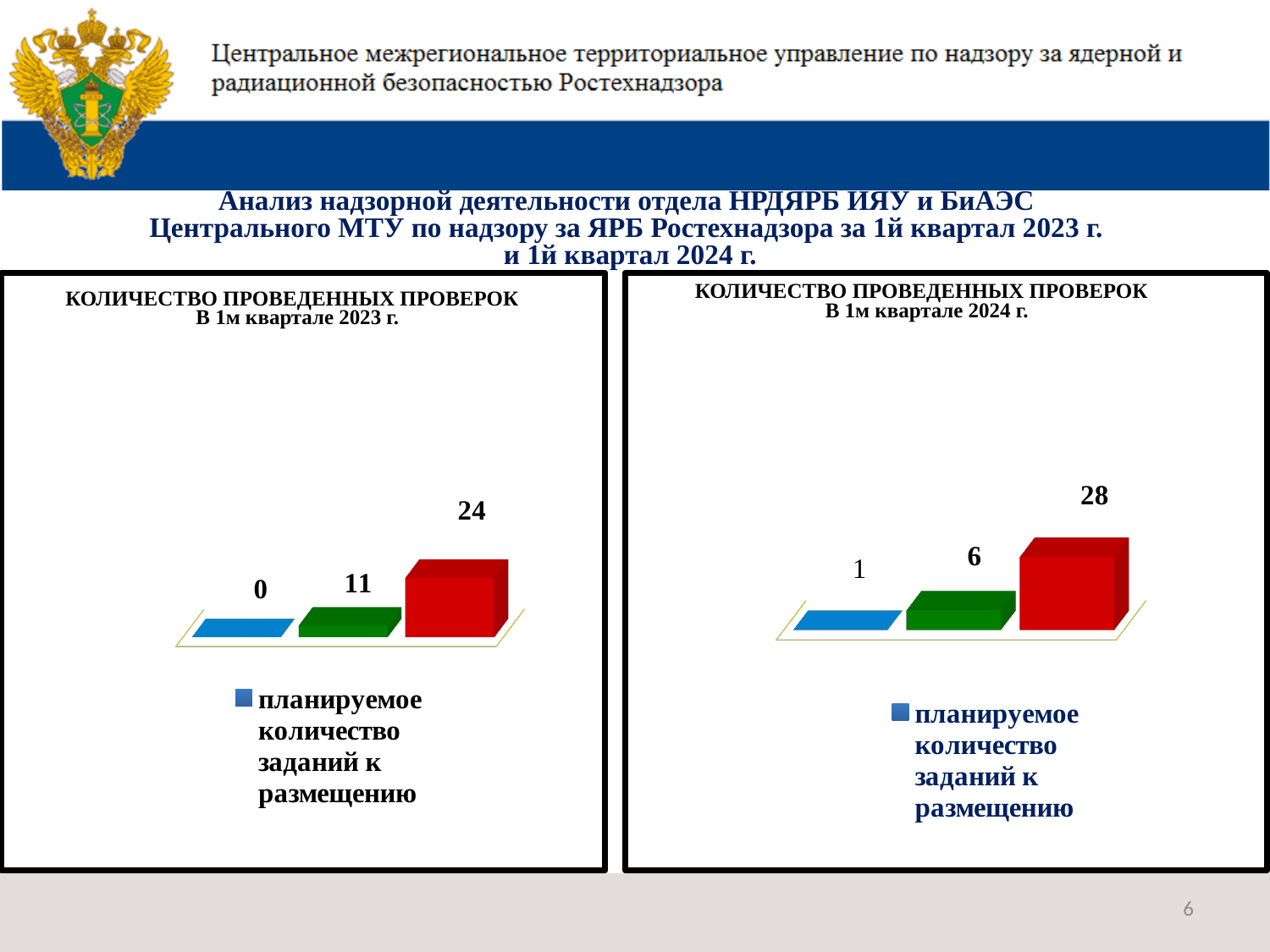
In the left chart (1st quarter 2023), what is the difference between the red bar and the green bar? 13 In the right chart (1st quarter 2024), which bar has the lowest value? the blue bar (1) In the right chart (1st quarter 2024), what is the value of the blue bar for 'планируемое количество заданий к размещению'? 1 In the right chart (1st quarter 2024), what value is shown on the green bar? 6 Which is larger: the red bar in the left chart (2023) or the red bar in the right chart (2024)? the red bar in the right chart (2024) In the left chart (1st quarter 2023), what value is shown on the red bar? 24 In the left chart (1st quarter 2023), what is the value of the blue bar for 'планируемое количество заданий к размещению'? 0 What type of chart is used in the left panel (1st quarter 2023)? bar chart In the right chart (1st quarter 2024), what is the difference between the red bar and the green bar? 22 How many bars are plotted in the right chart (1st quarter 2024)? 3 What is the title of the right chart? КОЛИЧЕСТВО ПРОВЕДЕННЫХ ПРОВЕРОК В 1м квартале 2024 г. In the left chart (1st quarter 2023), which bar has the highest value? the red bar (24)